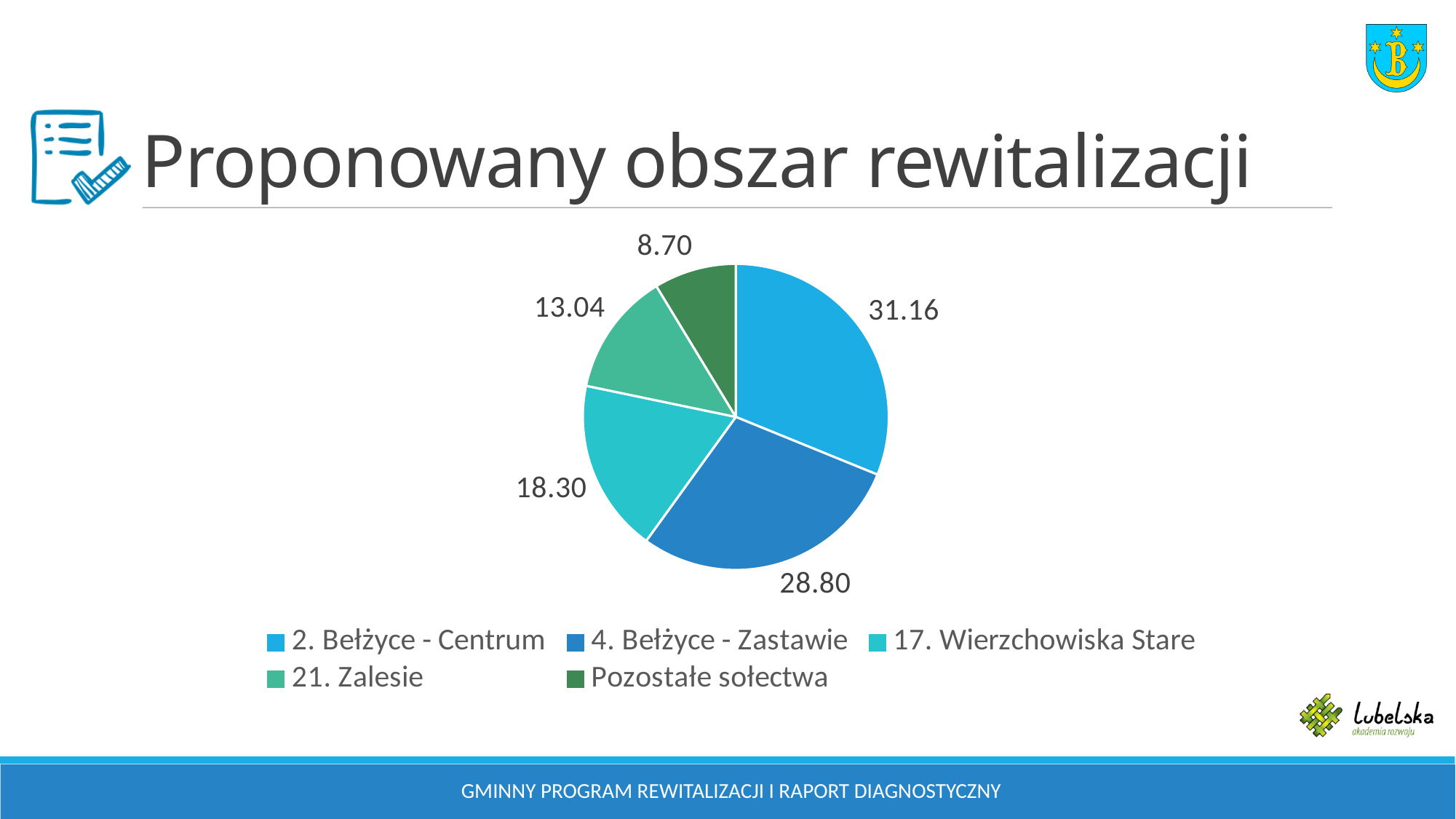
Which category has the smallest slice of the pie? Pozostałe sołectwa Which is larger, the value for 17. Wierzchowiska Stare or the value for 21. Zalesie? 17. Wierzchowiska Stare What is the title of the slide containing the pie chart? Proponowany obszar rewitalizacji What is the value for Pozostałe sołectwa? 8.70 What is the value for 2. Bełżyce - Centrum? 31.16 Which category has the largest slice of the pie? 2. Bełżyce - Centrum What type of chart is shown on the slide? pie chart What is the difference between the values for 2. Bełżyce - Centrum and 4. Bełżyce - Zastawie? 2.36 What is the value for 21. Zalesie? 13.04 What is the value for 17. Wierzchowiska Stare? 18.30 What is the value for 4. Bełżyce - Zastawie? 28.80 How many slices does the pie chart have? 5